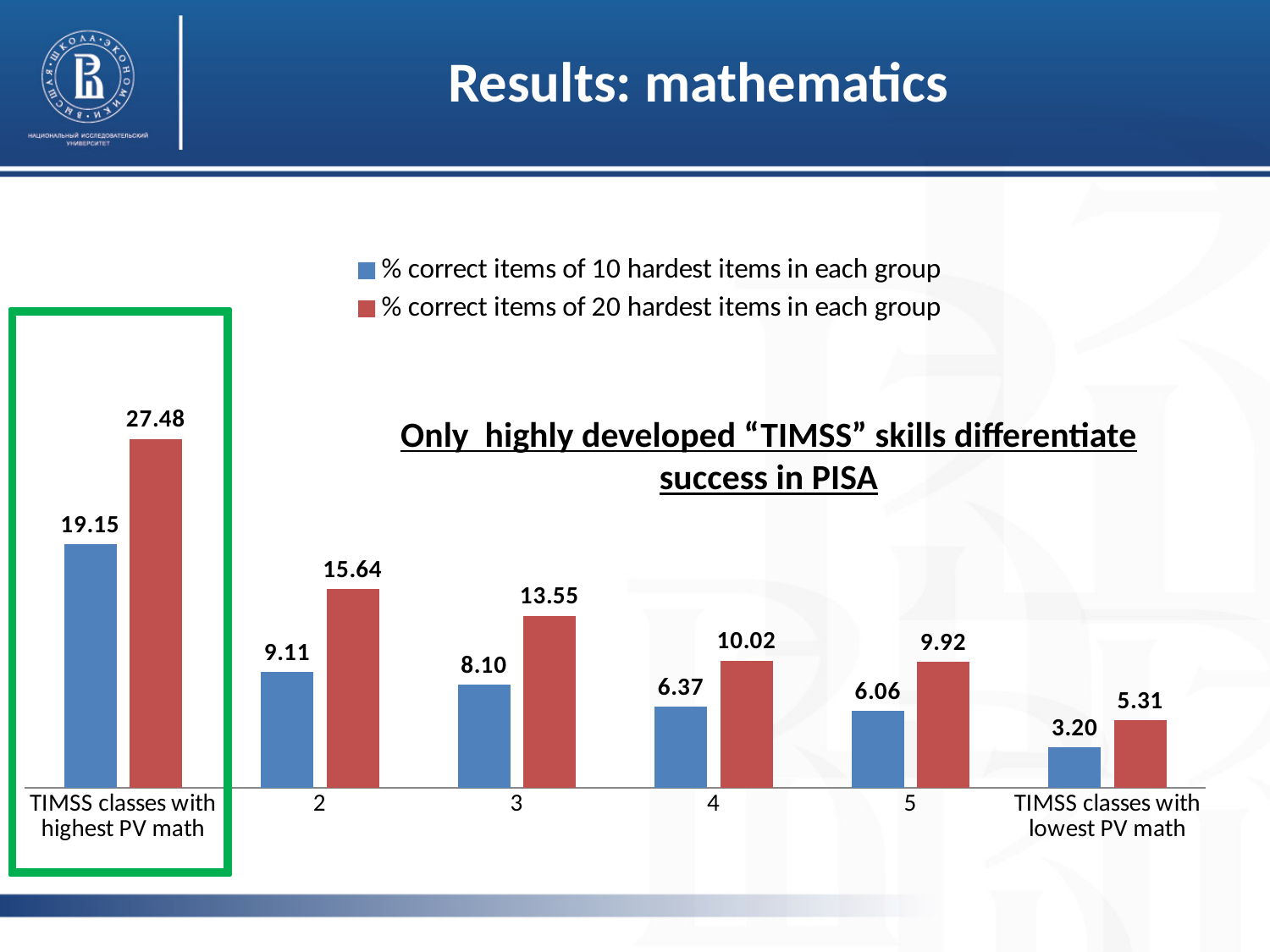
What is the value for '% correct items of 10 hardest items in each group' for TIMSS classes with lowest PV math? 3.20 How many categories are shown on the x axis? 6 Do the values for '% correct items of 20 hardest items in each group' rise or fall from left to right along the x axis? Fall What is the difference between the '% correct items of 20 hardest items in each group' values for category 2 and category 3? 2.09 What is the value for '% correct items of 20 hardest items in each group' for category 3? 13.55 Which category has the lowest value for '% correct items of 10 hardest items in each group'? TIMSS classes with lowest PV math What is the value for '% correct items of 10 hardest items in each group' for TIMSS classes with highest PV math? 19.15 Which is larger: the '% correct items of 10 hardest items in each group' value for category 4 or for category 5? Category 4 What is the difference between the two series values for TIMSS classes with highest PV math? 8.33 Which category has the highest value for '% correct items of 20 hardest items in each group'? TIMSS classes with highest PV math What kind of chart is shown on the slide? Bar chart How many series does the legend list? 2